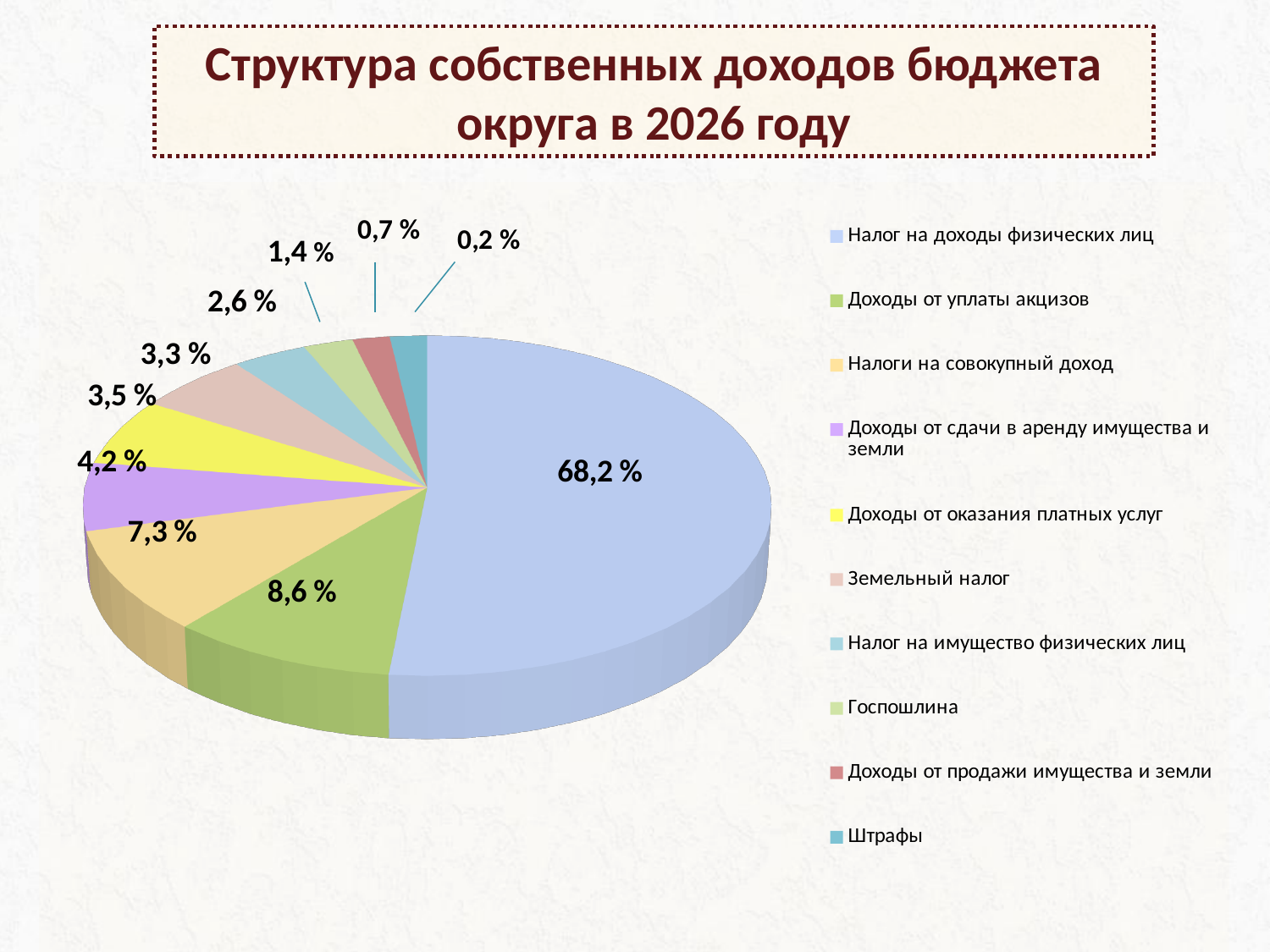
Which category has the largest share of the pie? Налог на доходы физических лиц How many categories does the legend list? 10 What is the value shown for "Налоги на совокупный доход"? 7,3 % What is the title of the chart? Структура собственных доходов бюджета округа в 2026 году What is the value shown for "Земельный налог"? 3,3 % Which category has the smallest share of the pie? Штрафы What is the value shown for "Штрафы"? 0,2 % What is the value shown for "Доходы от уплаты акцизов"? 8,6 % What share of the pie does "Налог на доходы физических лиц" have? 68,2 % Which is larger: the share of "Доходы от сдачи в аренду имущества и земли" or "Доходы от оказания платных услуг"? Доходы от сдачи в аренду имущества и земли What is the difference between the shares of "Доходы от уплаты акцизов" and "Налоги на совокупный доход"? 1,3 % What type of chart is shown on the slide? pie chart